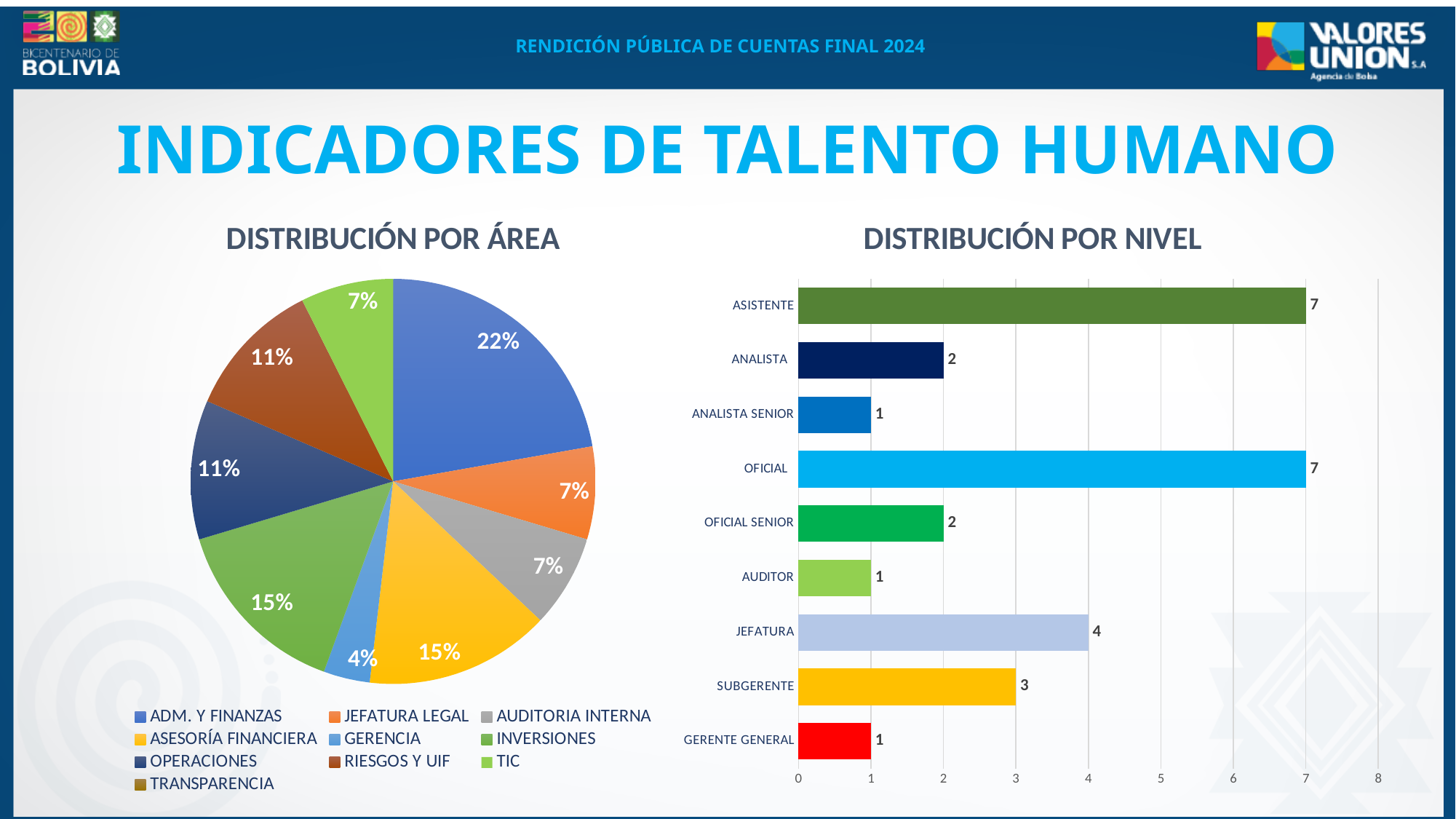
In the DISTRIBUCIÓN POR ÁREA chart, what kind of chart is shown? Pie chart In the DISTRIBUCIÓN POR ÁREA chart, how many entries does the legend list? 10 In the DISTRIBUCIÓN POR NIVEL chart, what kind of chart is shown? Bar chart In the DISTRIBUCIÓN POR NIVEL chart, what is the value for OFICIAL? 7 In the DISTRIBUCIÓN POR ÁREA chart, what share does ADM. Y FINANZAS have? 22% In the DISTRIBUCIÓN POR NIVEL chart, what is the value for SUBGERENTE? 3 In the DISTRIBUCIÓN POR ÁREA chart, what share does GERENCIA have? 4% In the DISTRIBUCIÓN POR ÁREA chart, which area has the largest share? ADM. Y FINANZAS In the DISTRIBUCIÓN POR ÁREA chart, which is larger, the share for INVERSIONES or the share for OPERACIONES? INVERSIONES In the DISTRIBUCIÓN POR NIVEL chart, how many levels are shown? 9 In the DISTRIBUCIÓN POR NIVEL chart, what is the difference between the values for ASISTENTE and JEFATURA? 3 In the DISTRIBUCIÓN POR NIVEL chart, what is the value for JEFATURA? 4